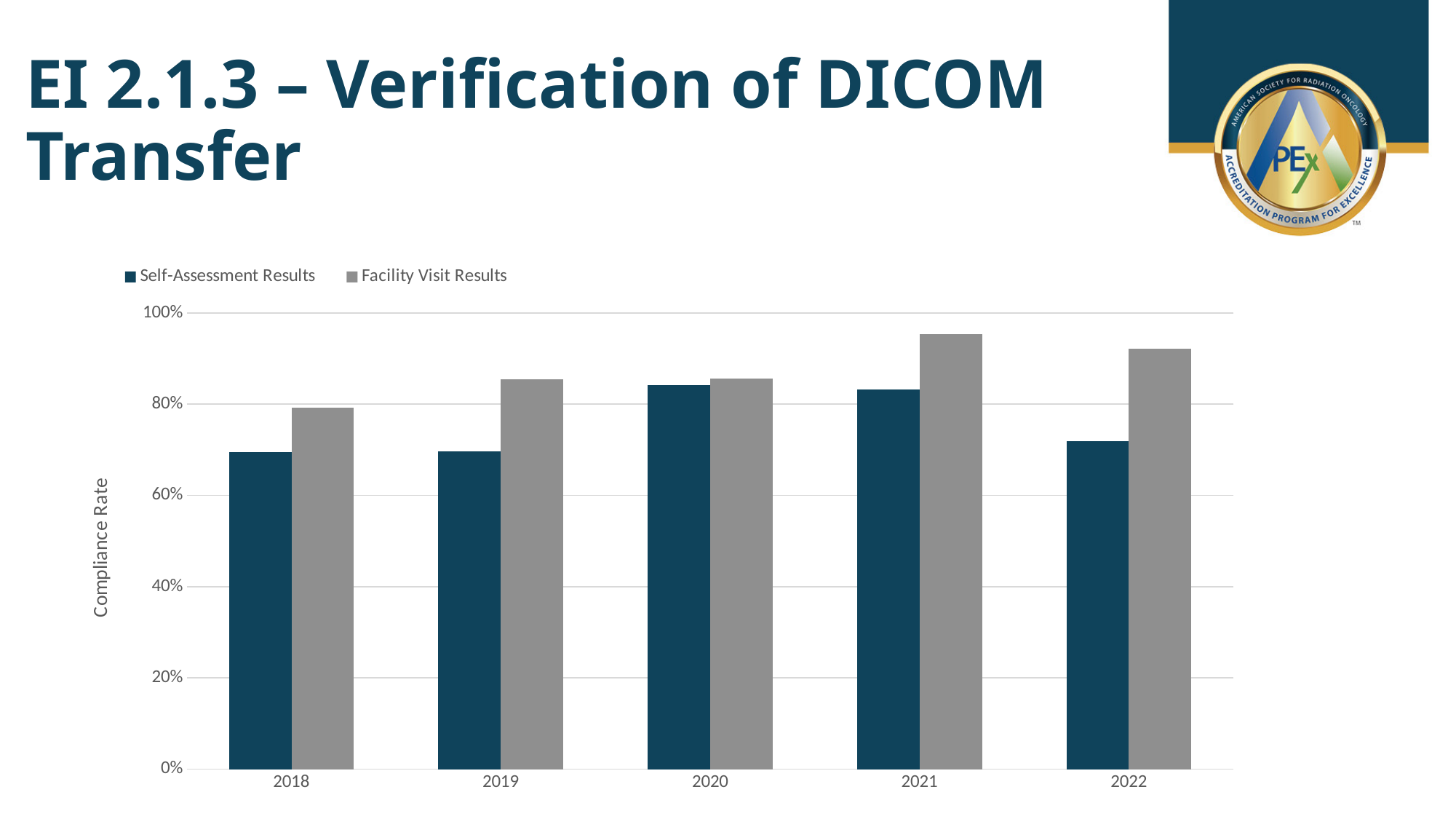
What is the label on the vertical axis? Compliance Rate Which year has the lowest Facility Visit Results value? 2018 What kind of chart is shown on the slide? bar chart Do the Facility Visit Results values rise or fall from 2018 to 2021? rise Is the Facility Visit Results value for 2021 greater or less than 90%? greater Is the Self-Assessment Results value for 2020 greater or less than 80%? greater Is the Facility Visit Results value for 2022 greater or less than 80%? greater In 2021, which is larger: Self-Assessment Results or Facility Visit Results? Facility Visit Results How many series does the legend list? 2 Which year has the highest Facility Visit Results value? 2021 How many years are shown on the x axis? 5